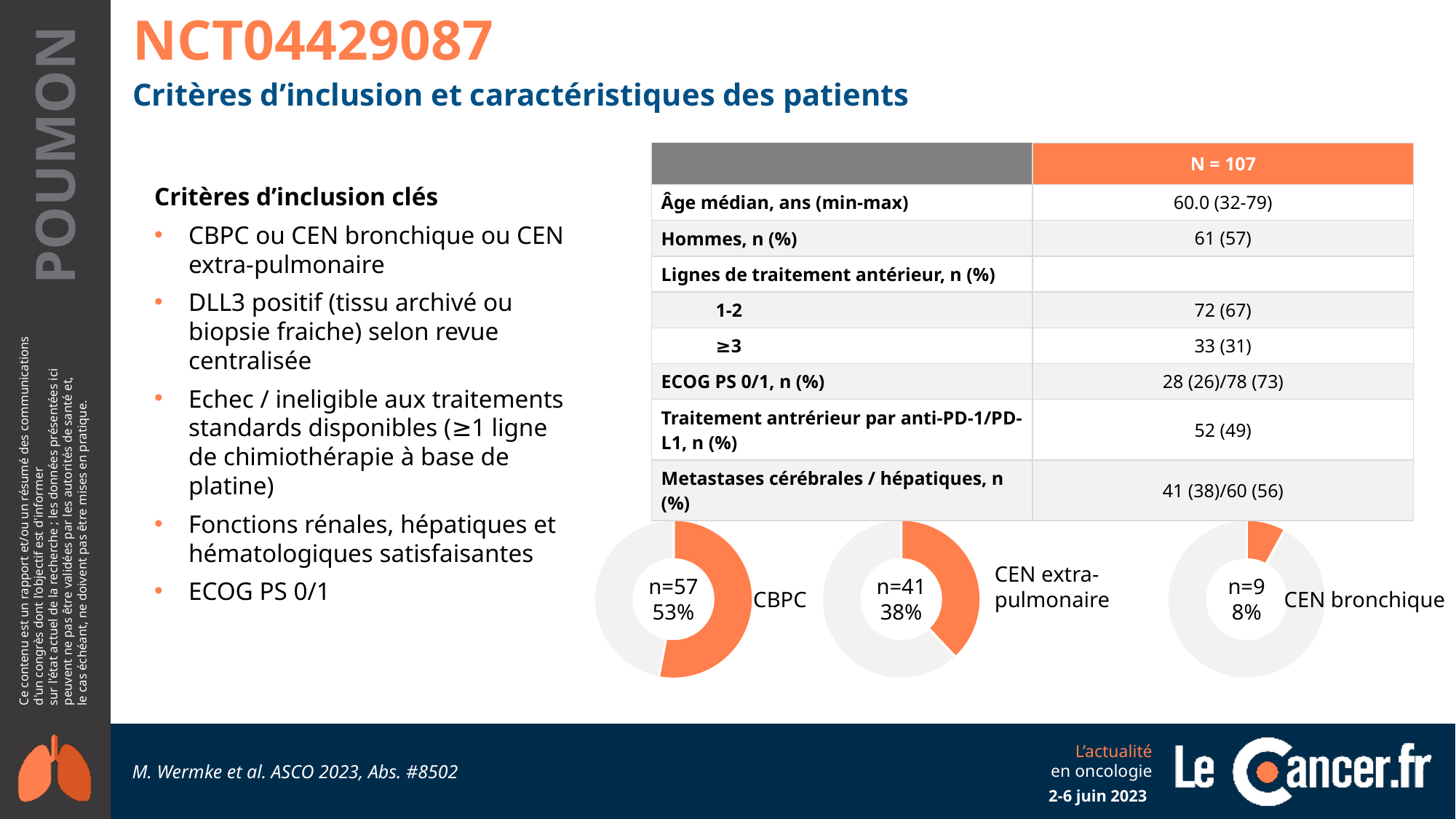
How many more patients are in the CBPC group than in the CEN extra-pulmonaire group, according to the donut charts? 16 Across the three donut charts, which patient group has the largest share? CBPC In the CBPC donut chart, what is the number of patients shown? n=57 Across the three donut charts, which patient group has the smallest share? CEN bronchique Which group has more patients according to the donut charts: CEN extra-pulmonaire or CEN bronchique? CEN extra-pulmonaire In the CEN extra-pulmonaire donut chart, what is the number of patients shown? n=41 In the CBPC donut chart, what percentage is shown? 53% How many donut charts are shown on the slide? 3 What kind of chart is used to show the CBPC share of patients? Donut chart In the CEN bronchique donut chart, what percentage is shown? 8% In the CEN bronchique donut chart, what is the number of patients shown? n=9 In the CEN extra-pulmonaire donut chart, what percentage is shown? 38%